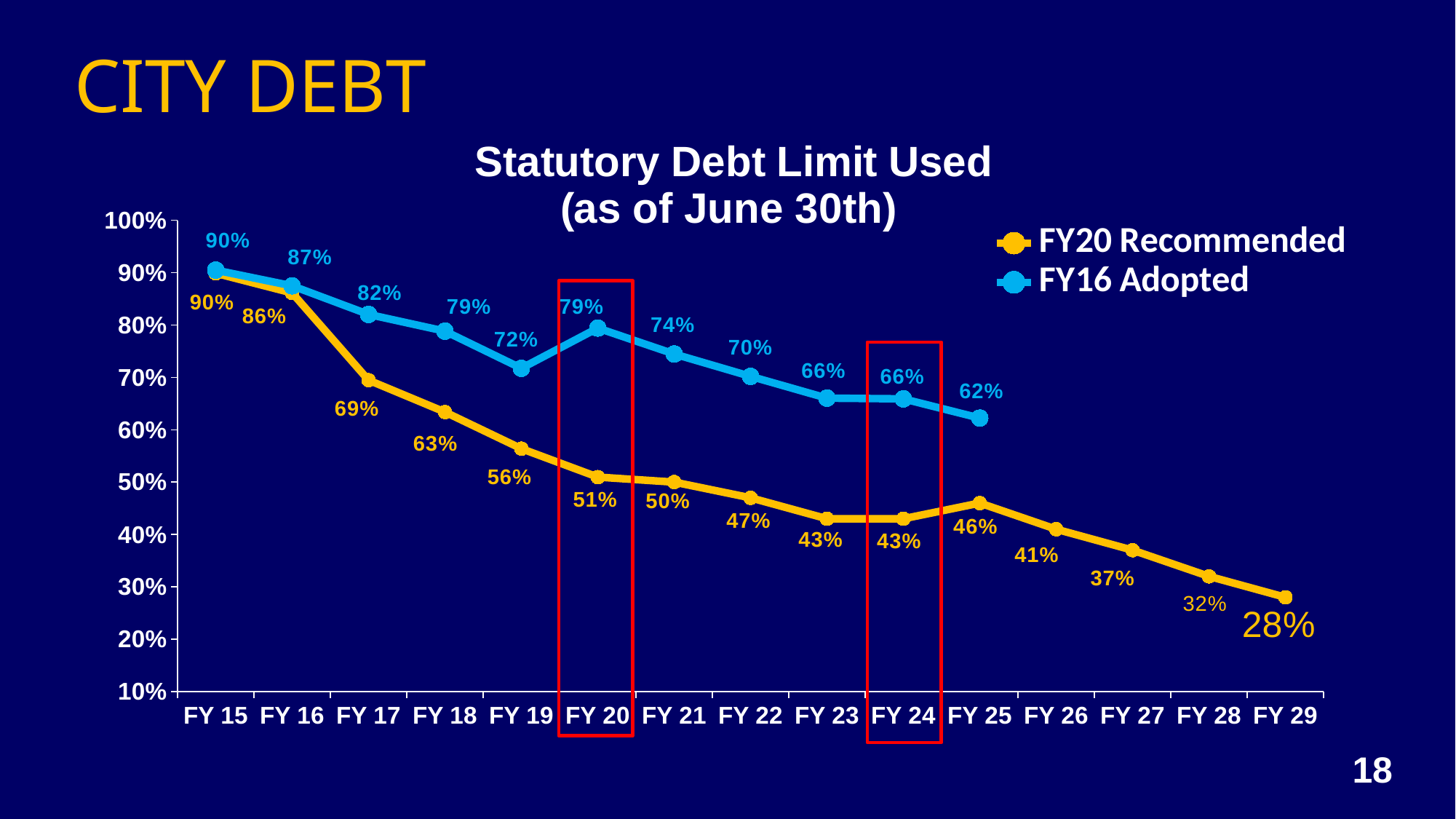
Does the FY20 Recommended series generally rise or fall from FY 15 to FY 29? fall What kind of chart is shown? line chart What is the FY20 Recommended value for FY 29? 28% What is the difference between the FY16 Adopted and FY20 Recommended values in FY 24? 23% How many series does the legend list? 2 Is the FY20 Recommended value for FY 26 greater or less than 50%? less What is the FY20 Recommended value for FY 20? 51% What is the FY16 Adopted value for FY 25? 62% Which is larger in FY 20: the FY16 Adopted value or the FY20 Recommended value? FY16 Adopted What is the FY16 Adopted value for FY 19? 72% In which fiscal year is the FY20 Recommended series at its lowest? FY 29 In which fiscal year is the FY16 Adopted series at its highest? FY 15